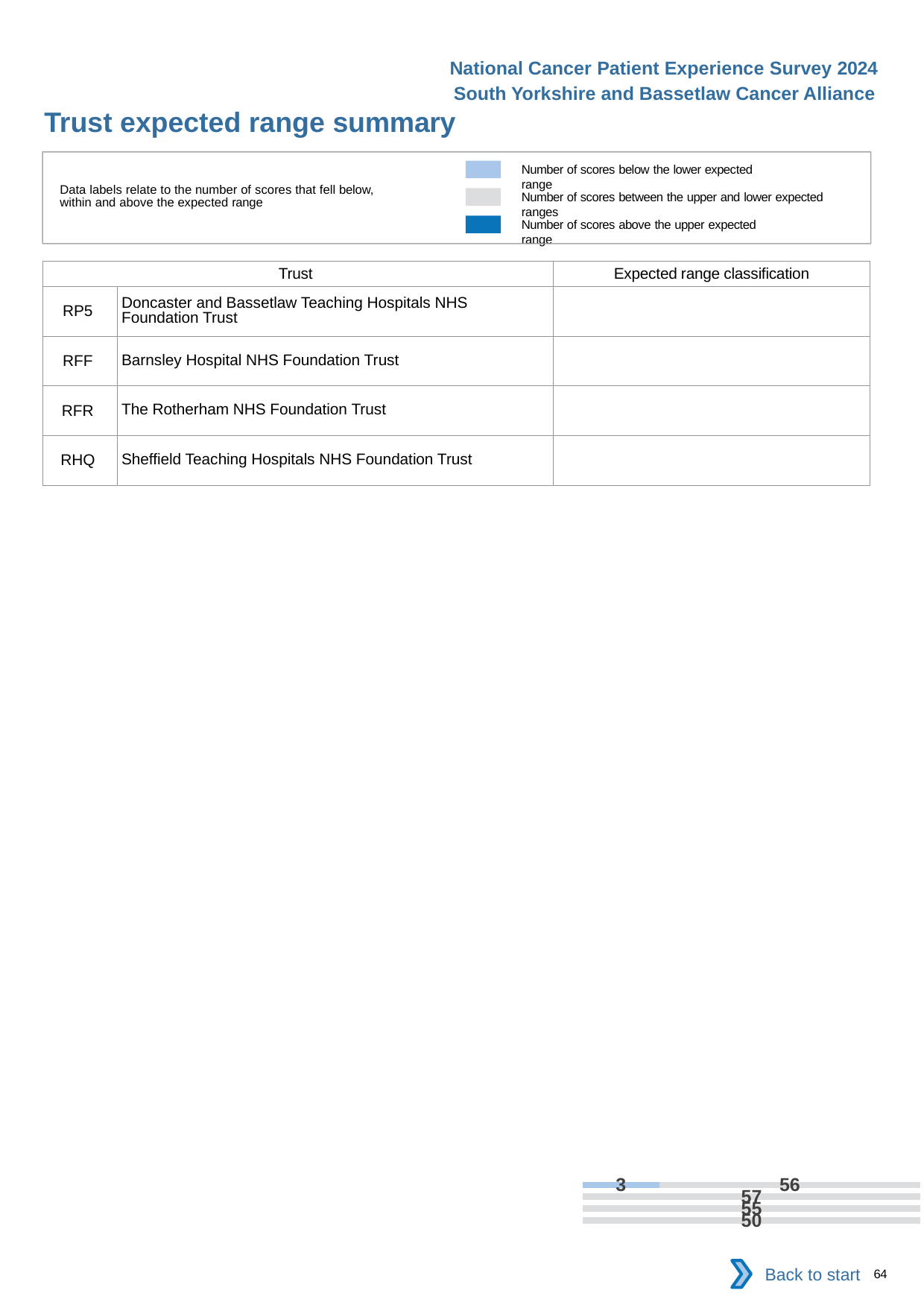
In the top bar of the chart, which segment is larger: the light blue segment or the grey segment? grey segment In the top bar of the chart, what is the data label on the grey segment (scores between the upper and lower expected ranges)? 56 According to the legend, what does the light blue colour represent? Number of scores below the lower expected range What kind of chart is shown at the bottom of the slide? bar chart How many horizontal bars are plotted in the chart at the bottom of the slide? 4 In the top bar of the chart, what is the data label on the light blue segment (scores below the lower expected range)? 3 What is the difference between the grey segment value and the light blue segment value in the top bar of the chart? 53 What is the total of the two labelled segments in the top bar of the chart? 59 How many categories does the legend in the box at the top of the slide list? 3 According to the legend, what does the dark blue colour represent? Number of scores above the upper expected range